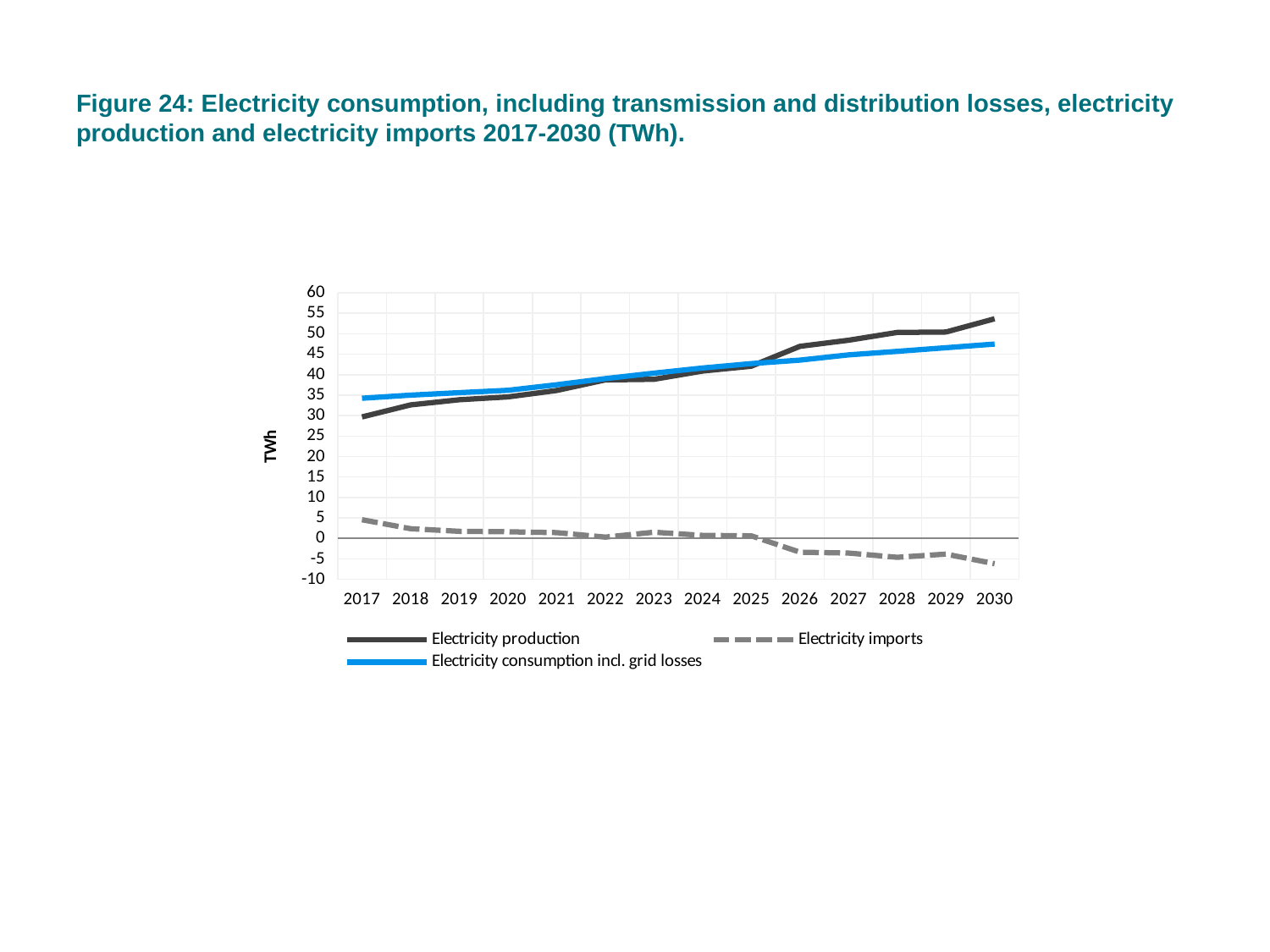
Is the value for Electricity production in 2025 greater or less than 40? greater Is the value for Electricity imports in 2017 greater or less than 0? greater Does Electricity imports rise or fall from 2017 to 2030? fall How many series does the legend list? 3 How many years are plotted along the x axis? 14 In which year is Electricity production highest? 2030 Is the value for Electricity consumption incl. grid losses in 2030 greater or less than 45? greater In which year is Electricity imports highest? 2017 In 2030, which is larger: Electricity production or Electricity consumption incl. grid losses? Electricity production What kind of chart is shown on the slide? line chart